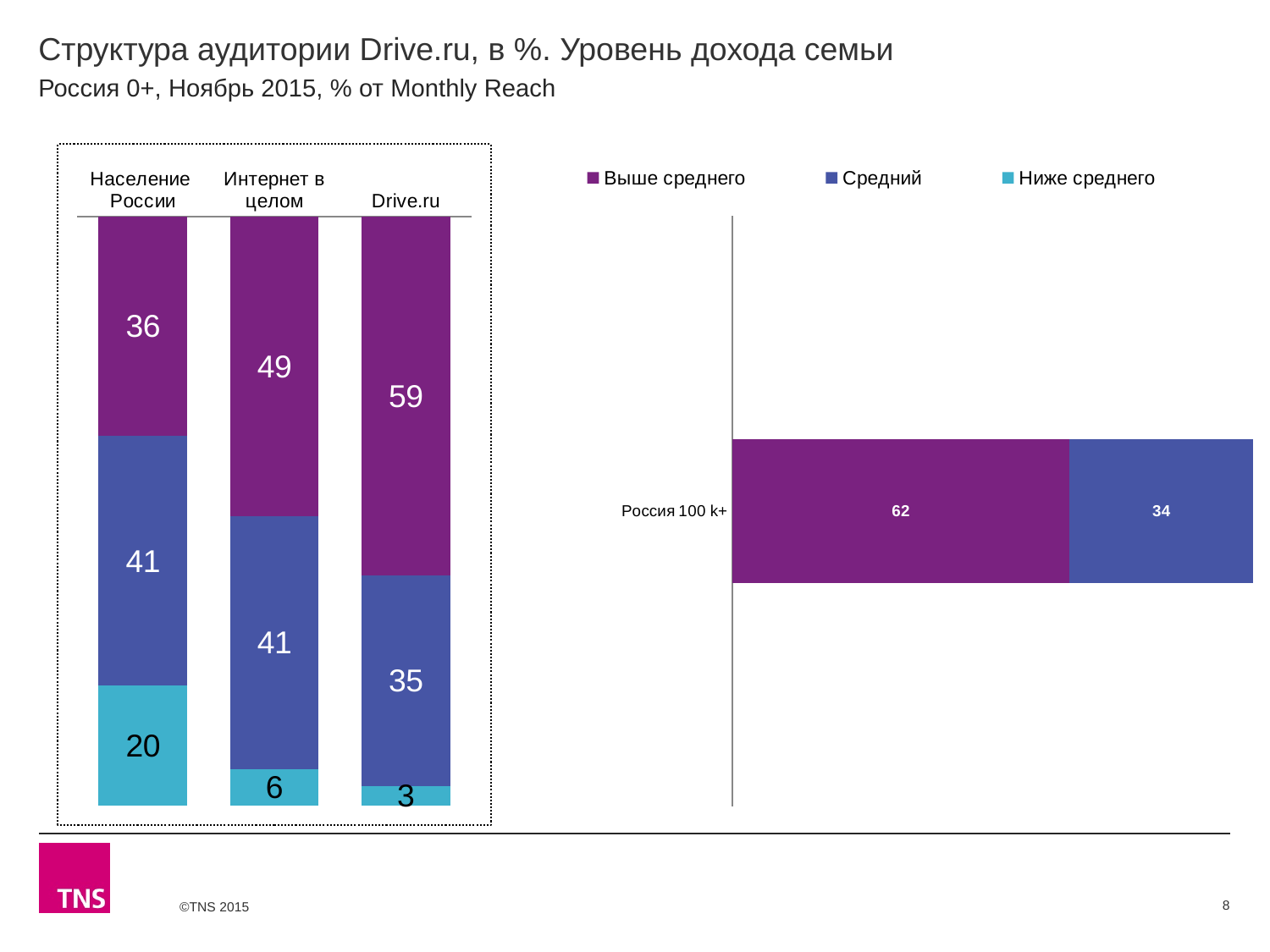
In the left chart, what is the value of Выше среднего for Drive.ru? 59 In the left chart, what is the value of Средний for Интернет в целом? 41 In the left chart, what is the difference between the Выше среднего values for Drive.ru and Население России? 23 In the left chart, which category has the highest value for Выше среднего? Drive.ru In the right chart, what is the value of Выше среднего for Россия 100 k+? 62 In the left chart, which category has the lowest value for Ниже среднего? Drive.ru What kind of chart is the right chart? Stacked bar chart In the right chart, what is the value of Средний for Россия 100 k+? 34 How many series does the legend list? 3 In the left chart, what is the value of Ниже среднего for Население России? 20 How many categories are shown in the left chart? 3 In the left chart, which is larger: Ниже среднего for Население России or for Интернет в целом? Население России